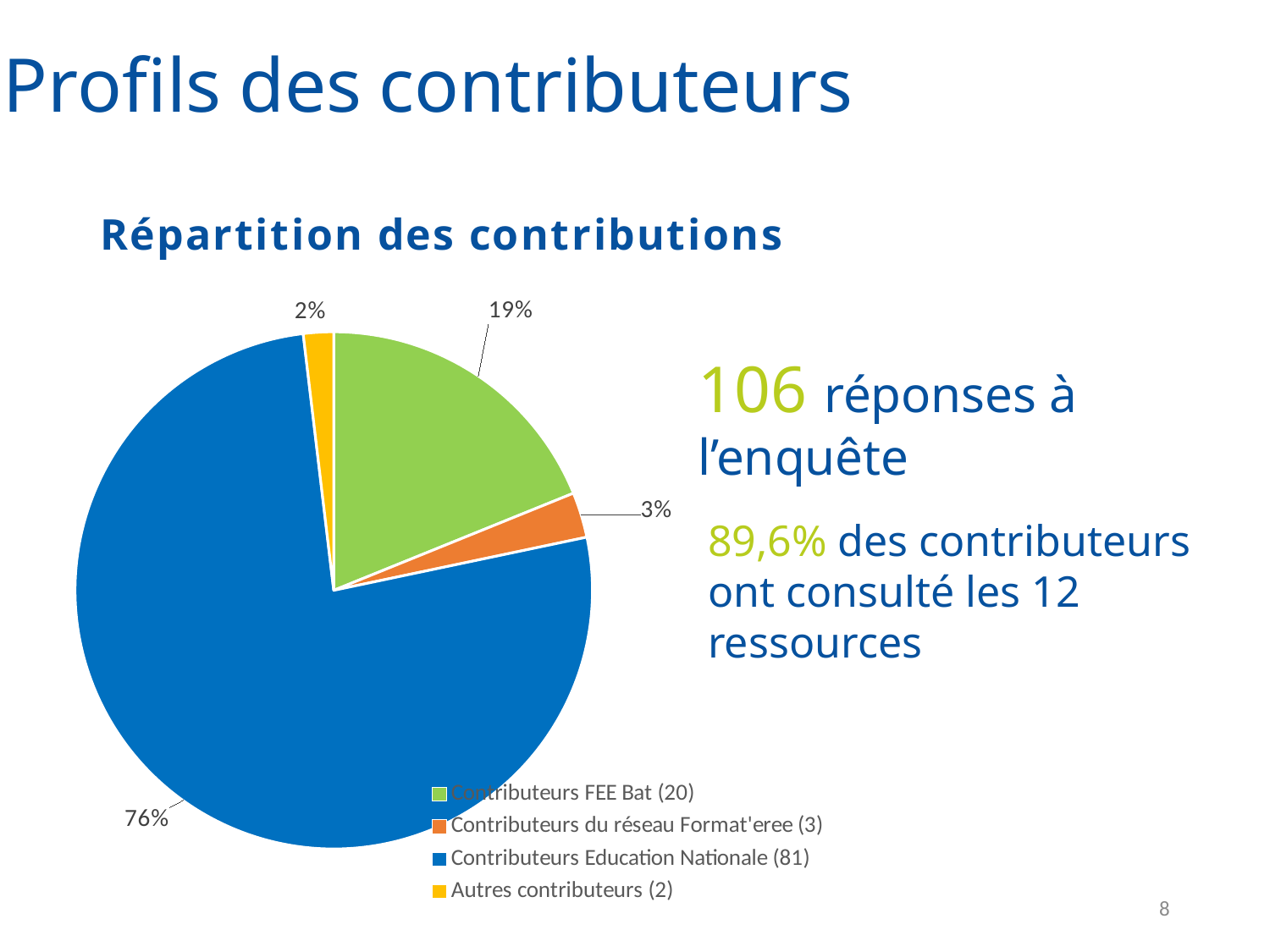
Which slice is larger: Contributeurs FEE Bat (20) or Contributeurs du réseau Format'eree (3)? Contributeurs FEE Bat (20) What is the title of the chart? Répartition des contributions What share of the pie is Autres contributeurs (2)? 2% What is the difference in percentage points between the Contributeurs Education Nationale slice and the Contributeurs FEE Bat slice? 57 percentage points What share of the pie is Contributeurs Education Nationale (81)? 76% What share of the pie is Contributeurs du réseau Format'eree (3)? 3% Which category has the smallest slice of the pie? Autres contributeurs (2) How many categories does the pie chart have? 4 What colour is the slice for Contributeurs du réseau Format'eree (3)? orange Which category has the largest slice of the pie? Contributeurs Education Nationale (81) What kind of chart is shown on the slide? pie chart